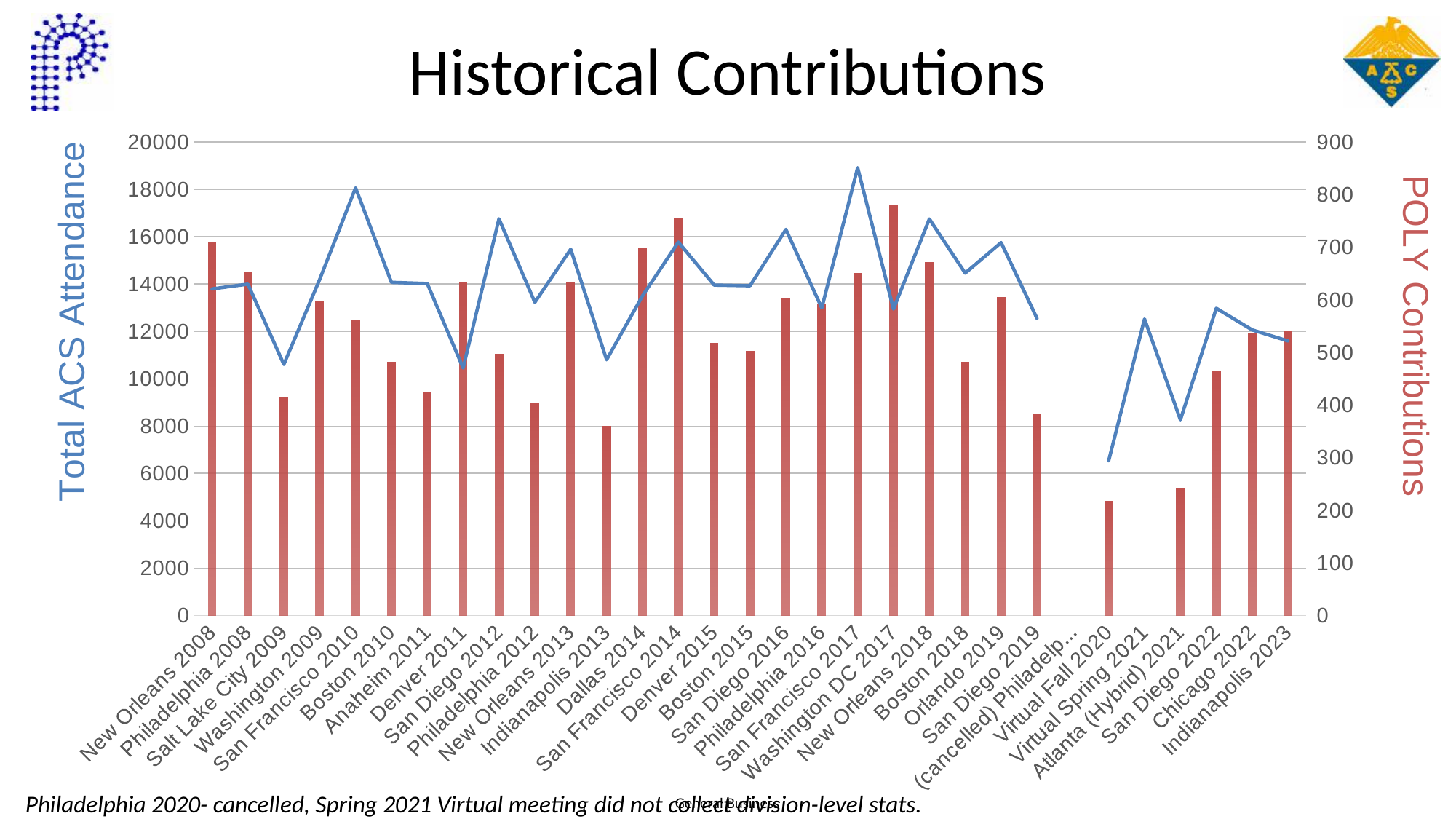
Which meeting has the highest POLY Contributions bar? Washington DC 2017 What is the title of the left vertical axis? Total ACS Attendance Is the Total ACS Attendance for Atlanta (Hybrid) 2021 greater or less than 10000? less Which has the higher Total ACS Attendance, San Francisco 2017 or Salt Lake City 2009? San Francisco 2017 Is the POLY Contributions value for Washington DC 2017 greater or less than 700? greater Which has the larger POLY Contributions bar, Washington DC 2017 or Boston 2018? Washington DC 2017 What is the title of the right vertical axis? POLY Contributions What kind of chart is shown on the slide? A combination bar and line chart Which meeting has the lowest non-zero POLY Contributions bar? Virtual Fall 2020 Is the Total ACS Attendance for San Francisco 2010 greater or less than 16000? greater Which meeting has the highest Total ACS Attendance on the line? San Francisco 2017